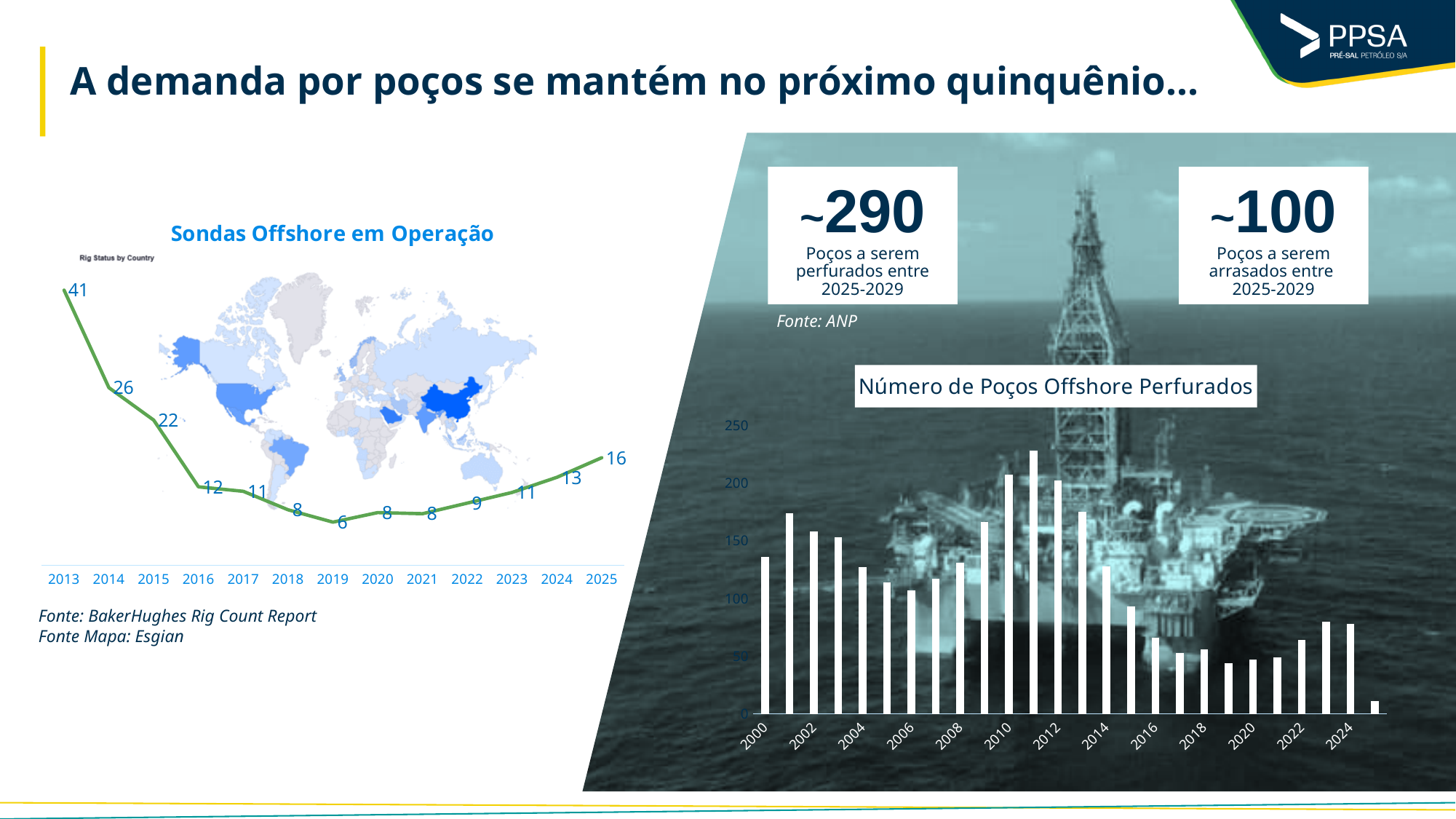
In the 'Sondas Offshore em Operação' chart, what is the value for 2025? 16 In the 'Número de Poços Offshore Perfurados' chart, is the value for 2011 greater or less than 200? greater In the 'Sondas Offshore em Operação' chart, which year has the highest value? 2013 In the 'Sondas Offshore em Operação' chart, which is larger, the value for 2016 or the value for 2024? 2024 In the 'Sondas Offshore em Operação' chart, do the values rise or fall from 2019 to 2025? rise In the 'Sondas Offshore em Operação' chart, how many years are plotted on the x axis? 13 What kind of chart is 'Número de Poços Offshore Perfurados'? bar chart What kind of chart is 'Sondas Offshore em Operação'? line chart In the 'Sondas Offshore em Operação' chart, which year has the lowest value? 2019 In the 'Número de Poços Offshore Perfurados' chart, is the value for 2019 greater or less than 100? less In the 'Sondas Offshore em Operação' chart, what is the value for 2013? 41 In the 'Sondas Offshore em Operação' chart, what is the difference between the values for 2013 and 2014? 15